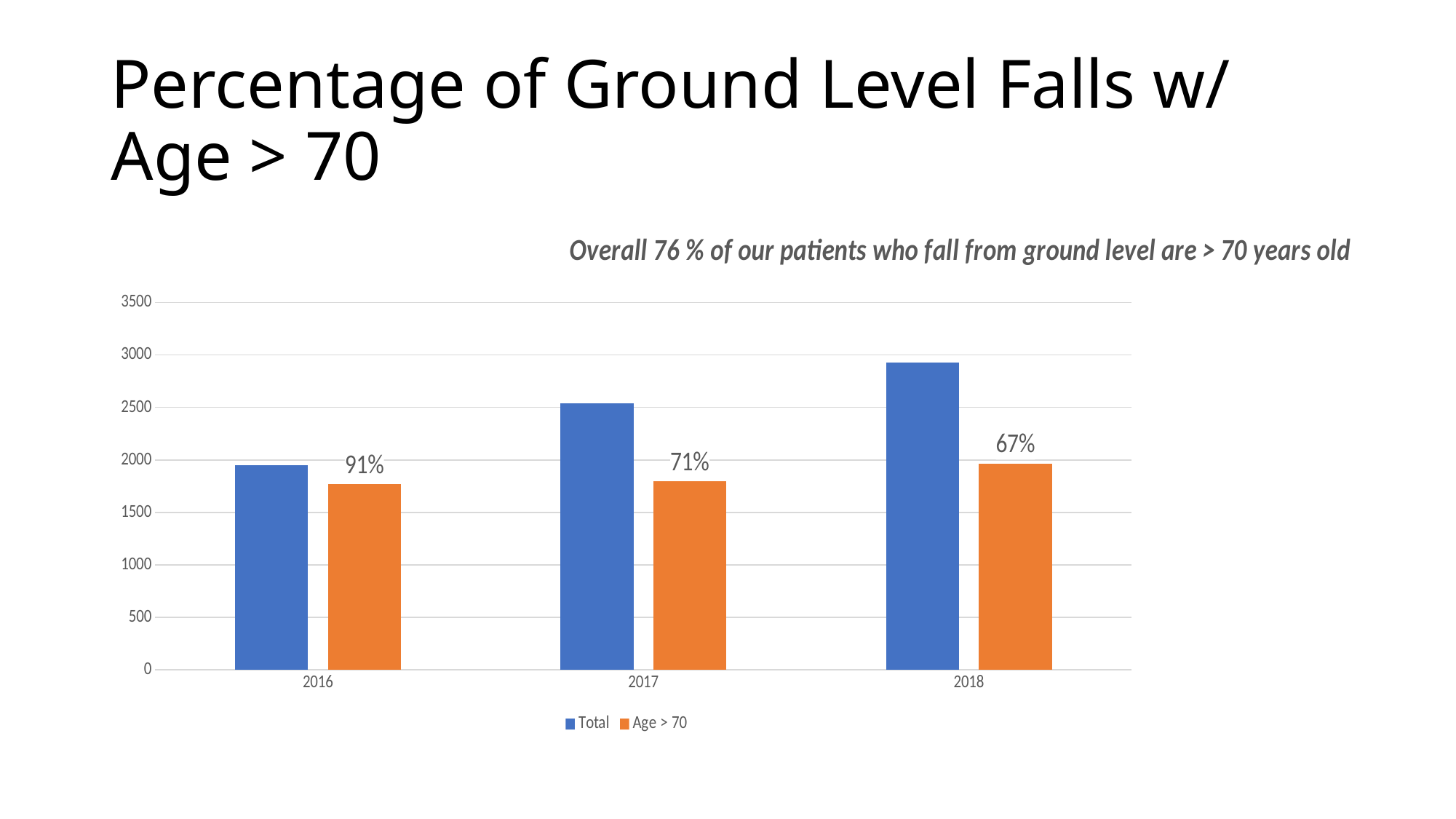
What kind of chart is shown on the slide? bar chart What percentage label is shown above the Age > 70 bar for 2018? 67% Do the Total values rise or fall from 2016 to 2018? rise What percentage label is shown above the Age > 70 bar for 2017? 71% Which year has the lowest Total bar? 2016 How many years are shown on the x axis? 3 In 2017, which is larger, the Total bar or the Age > 70 bar? Total How many series does the legend list? 2 What percentage label is shown above the Age > 70 bar for 2016? 91% Which year has the highest Total bar? 2018